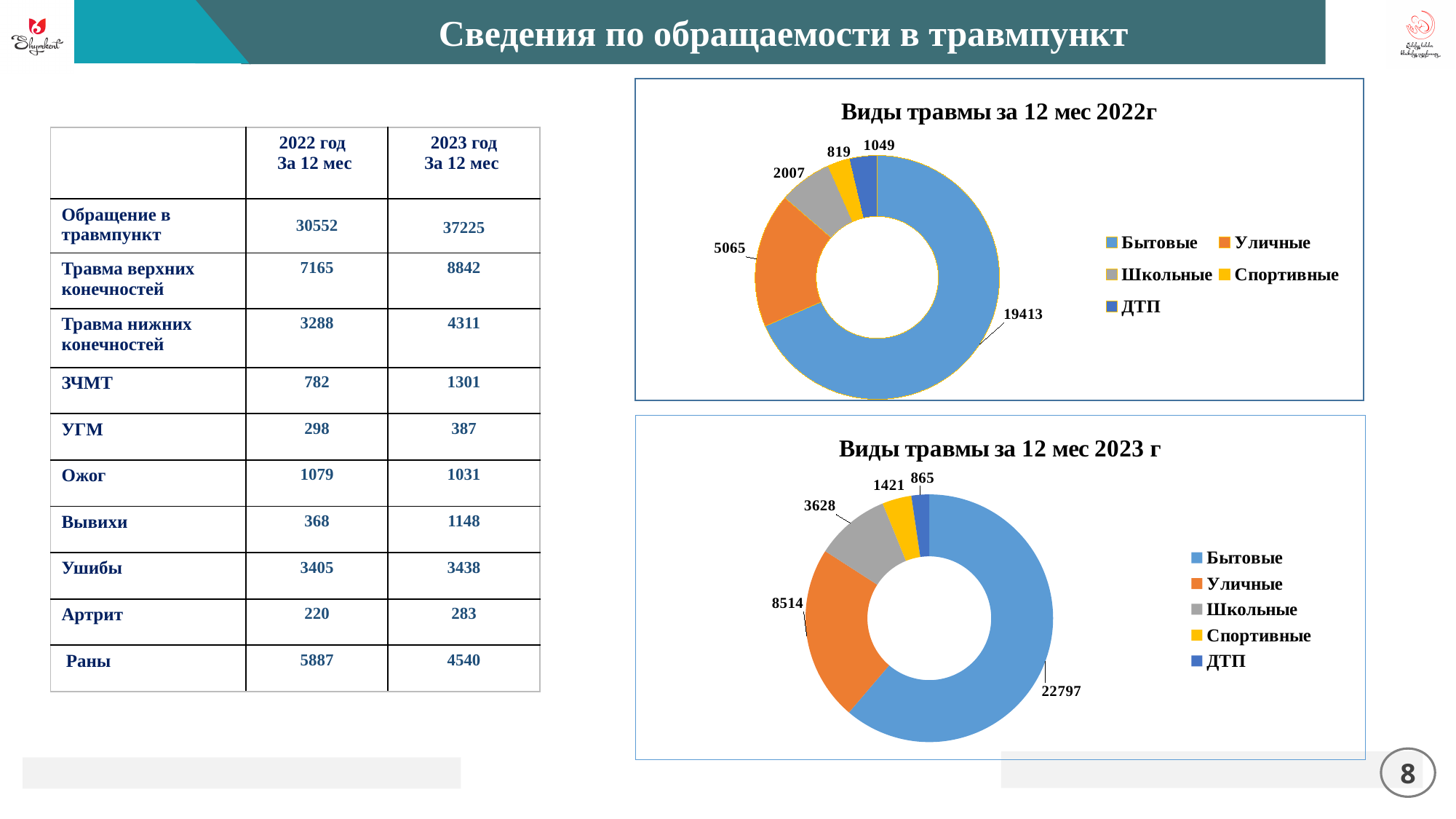
In the chart 'Виды травмы за 12 мес 2022г', what is the difference between Бытовые and Уличные? 14348 In the chart 'Виды травмы за 12 мес 2022г', what is the value for Бытовые? 19413 In the chart 'Виды травмы за 12 мес 2023 г', what is the value for ДТП? 865 In the chart 'Виды травмы за 12 мес 2022г', what is the value for Школьные? 2007 In the chart 'Виды травмы за 12 мес 2022г', what colour represents Уличные? Orange How many categories does the chart 'Виды травмы за 12 мес 2022г' show? 5 In the chart 'Виды травмы за 12 мес 2023 г', what is the value for Уличные? 8514 In the chart 'Виды травмы за 12 мес 2023 г', which category has the largest value? Бытовые In the chart 'Виды травмы за 12 мес 2023 г', which is larger: Спортивные or ДТП? Спортивные What is the difference between the Уличные value in the 2023 chart and the Уличные value in the 2022 chart? 3449 What kind of chart is 'Виды травмы за 12 мес 2023 г'? Doughnut chart In the chart 'Виды травмы за 12 мес 2022г', which category has the smallest value? Спортивные